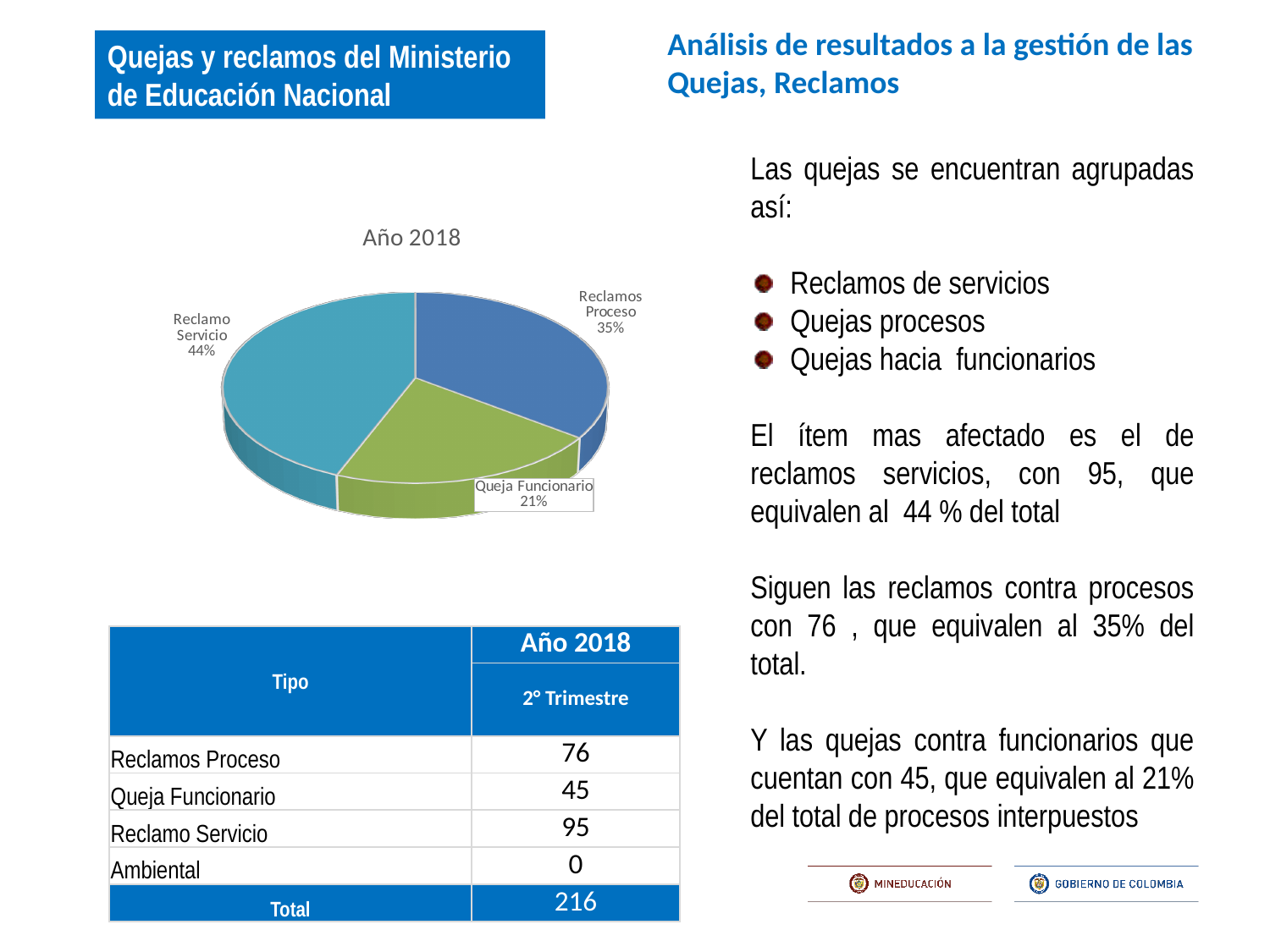
What is the difference in percentage points between the Reclamo Servicio slice and the Queja Funcionario slice? 23% Which category has the smallest slice of the pie? Queja Funcionario What is the difference in percentage points between the Reclamo Servicio slice and the Reclamos Proceso slice? 9% What share of the pie does Queja Funcionario represent? 21% What is the title of the pie chart? Año 2018 Which slice is larger, Reclamos Proceso or Queja Funcionario? Reclamos Proceso How many slices does the pie chart have? 3 What share of the pie does Reclamos Proceso represent? 35% Which category has the largest slice of the pie? Reclamo Servicio What type of chart is shown on the slide? Pie chart What colour is the Queja Funcionario slice of the pie? Green What share of the pie does Reclamo Servicio represent? 44%